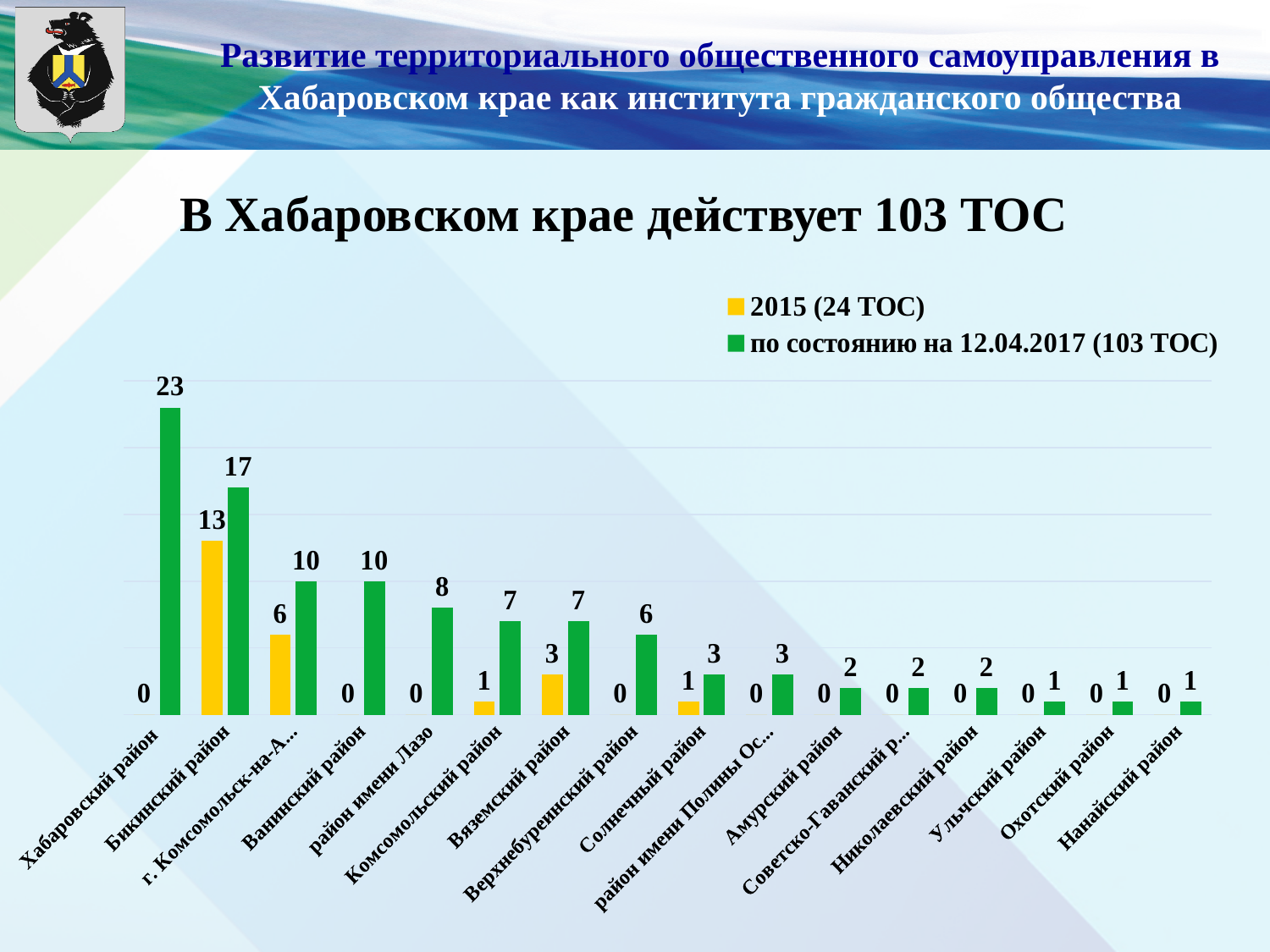
Do the values in the series 'по состоянию на 12.04.2017 (103 ТОС)' generally rise or fall from left to right along the x axis? fall How many districts (categories) are shown on the x axis? 16 Which district has the highest value in the series '2015 (24 ТОС)'? Бикинский район How many series does the legend list? 2 What is the value for Вяземский район in the series '2015 (24 ТОС)'? 3 What colour are the bars for the series '2015 (24 ТОС)'? yellow Which is larger for Ванинский район: the 2015 value or the 12.04.2017 value? the 12.04.2017 value Which district has the highest value in the series 'по состоянию на 12.04.2017 (103 ТОС)'? Хабаровский район What is the value for Хабаровский район in the series 'по состоянию на 12.04.2017 (103 ТОС)'? 23 What type of chart is shown on the slide? bar chart What is the difference between the 2017 and 2015 values for Бикинский район? 4 What is the value for Бикинский район in the series '2015 (24 ТОС)'? 13